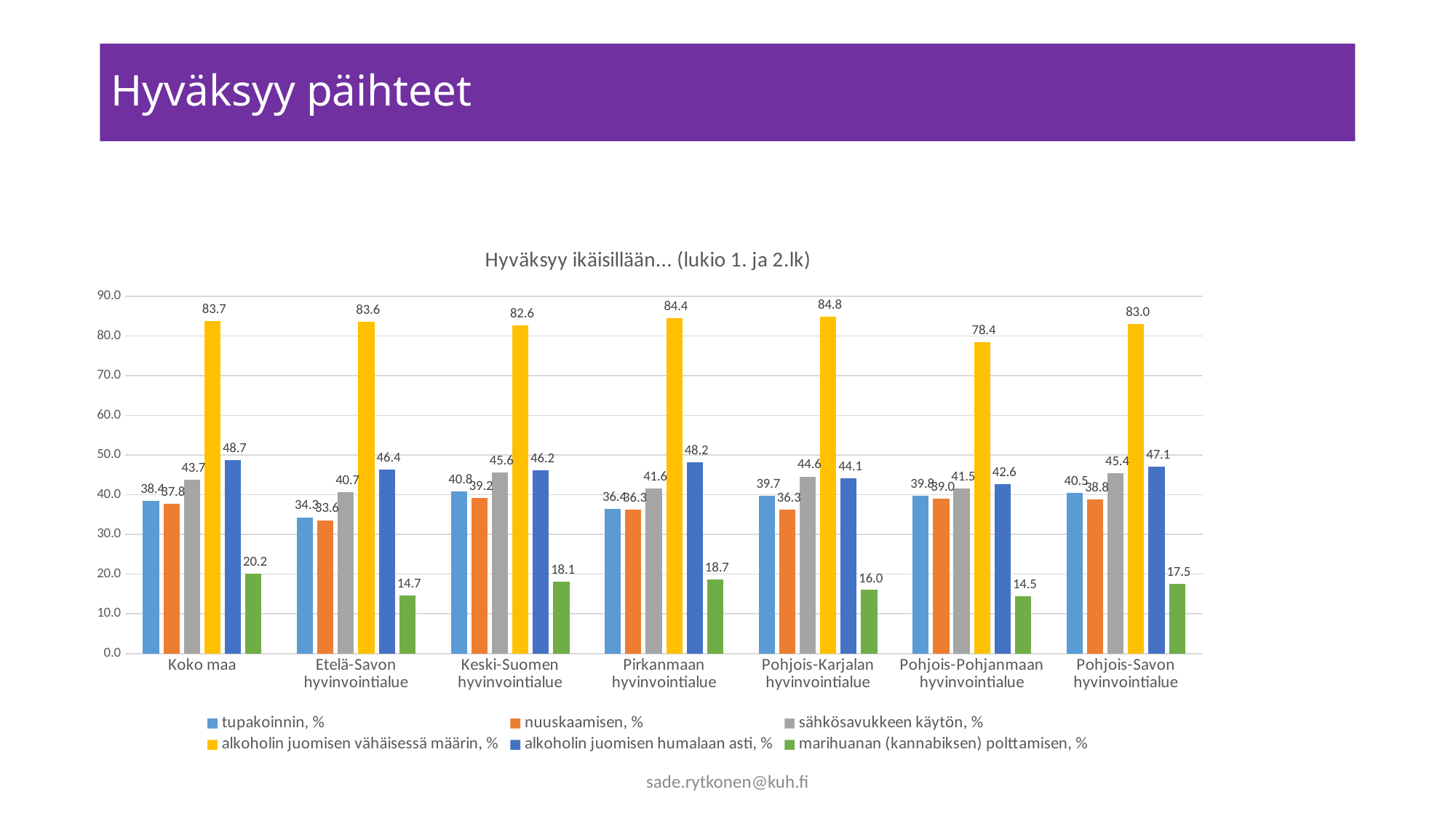
Which category has the lowest value for 'marihuanan (kannabiksen) polttamisen, %'? Pohjois-Pohjanmaan hyvinvointialue Is the value for 'alkoholin juomisen humalaan asti, %' for Pirkanmaan hyvinvointialue greater or less than 40.0? greater What kind of chart is shown on the slide? bar chart Which has the larger value for 'sähkösavukkeen käytön, %': Keski-Suomen hyvinvointialue or Etelä-Savon hyvinvointialue? Keski-Suomen hyvinvointialue What is the value for 'marihuanan (kannabiksen) polttamisen, %' for Koko maa? 20.2 How many series does the legend list? 6 What is the difference between the 'alkoholin juomisen vähäisessä määrin, %' values for Pohjois-Karjalan hyvinvointialue and Pohjois-Pohjanmaan hyvinvointialue? 6.4 For Koko maa, what is the difference between 'alkoholin juomisen humalaan asti, %' and 'marihuanan (kannabiksen) polttamisen, %'? 28.5 What is the value for 'sähkösavukkeen käytön, %' for Pohjois-Karjalan hyvinvointialue? 44.6 What is the value for 'alkoholin juomisen vähäisessä määrin, %' for Pohjois-Pohjanmaan hyvinvointialue? 78.4 Which category has the highest value for 'alkoholin juomisen vähäisessä määrin, %'? Pohjois-Karjalan hyvinvointialue How many categories are shown on the x axis? 7